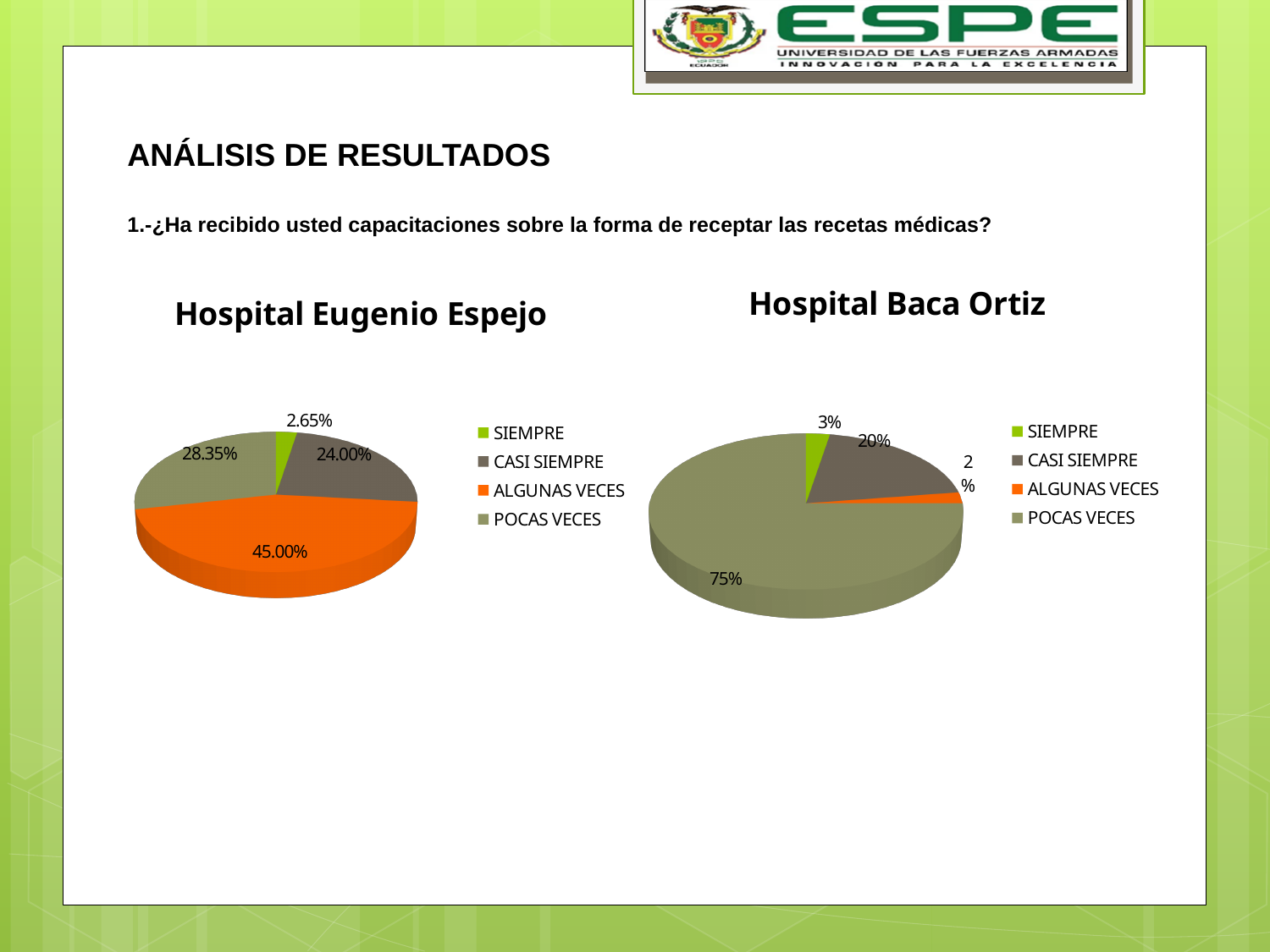
In the Hospital Eugenio Espejo chart, which category has the smallest slice? SIEMPRE In the Hospital Eugenio Espejo chart, what percentage is shown for ALGUNAS VECES? 45.00% In the Hospital Baca Ortiz chart, which is larger, CASI SIEMPRE or SIEMPRE? CASI SIEMPRE In the Hospital Eugenio Espejo chart, which category has the largest slice? ALGUNAS VECES In the Hospital Baca Ortiz chart, what percentage is shown for POCAS VECES? 75% In the Hospital Eugenio Espejo chart, what percentage is shown for POCAS VECES? 28.35% In the Hospital Eugenio Espejo chart, what percentage is shown for SIEMPRE? 2.65% In the Hospital Baca Ortiz chart, which category has the largest slice? POCAS VECES What kind of chart is the Hospital Eugenio Espejo chart? Pie chart How many categories does the legend of the Hospital Baca Ortiz chart list? 4 In the Hospital Eugenio Espejo chart, what is the difference between the ALGUNAS VECES and CASI SIEMPRE percentages? 21.00% In the Hospital Baca Ortiz chart, what percentage is shown for CASI SIEMPRE? 20%